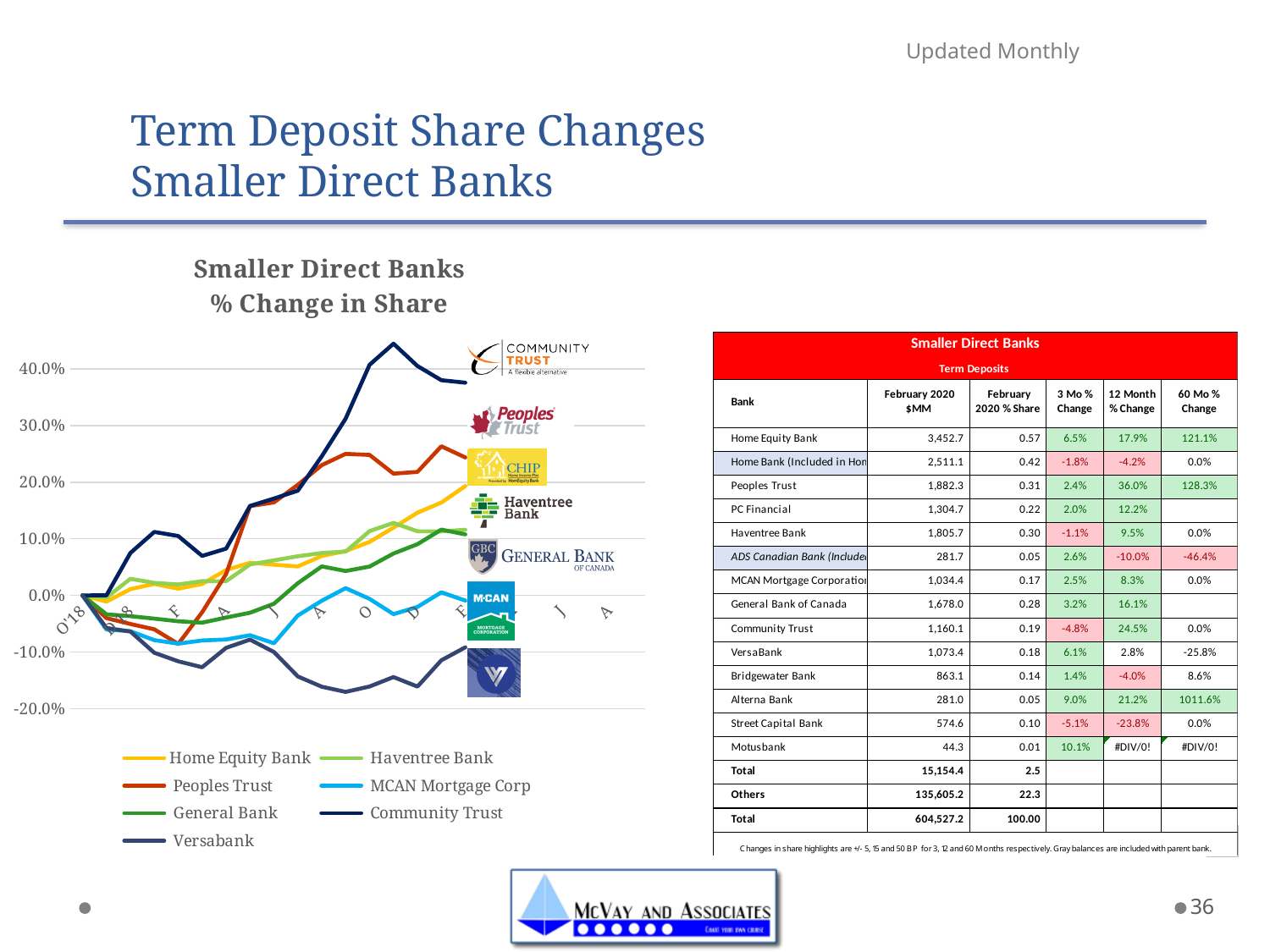
Which series reaches the lowest value on the chart? Versabank How many series does the chart legend list? 7 Is the peak value for Peoples Trust greater or less than 20.0%? greater Which series reaches the highest value on the chart? Community Trust At the right end of the chart, which is higher: Community Trust or Peoples Trust? Community Trust Is the lowest value for Versabank greater or less than -10.0%? less Does the Versabank line generally rise or fall from left to right? fall What kind of chart is shown on the slide? line chart At the right end of the chart, which is higher: Home Equity Bank or MCAN Mortgage Corp? Home Equity Bank What is the title of the chart? Smaller Direct Banks % Change in Share Does the Community Trust line generally rise or fall from left to right? rise Is the peak value for Community Trust greater or less than 40.0%? greater